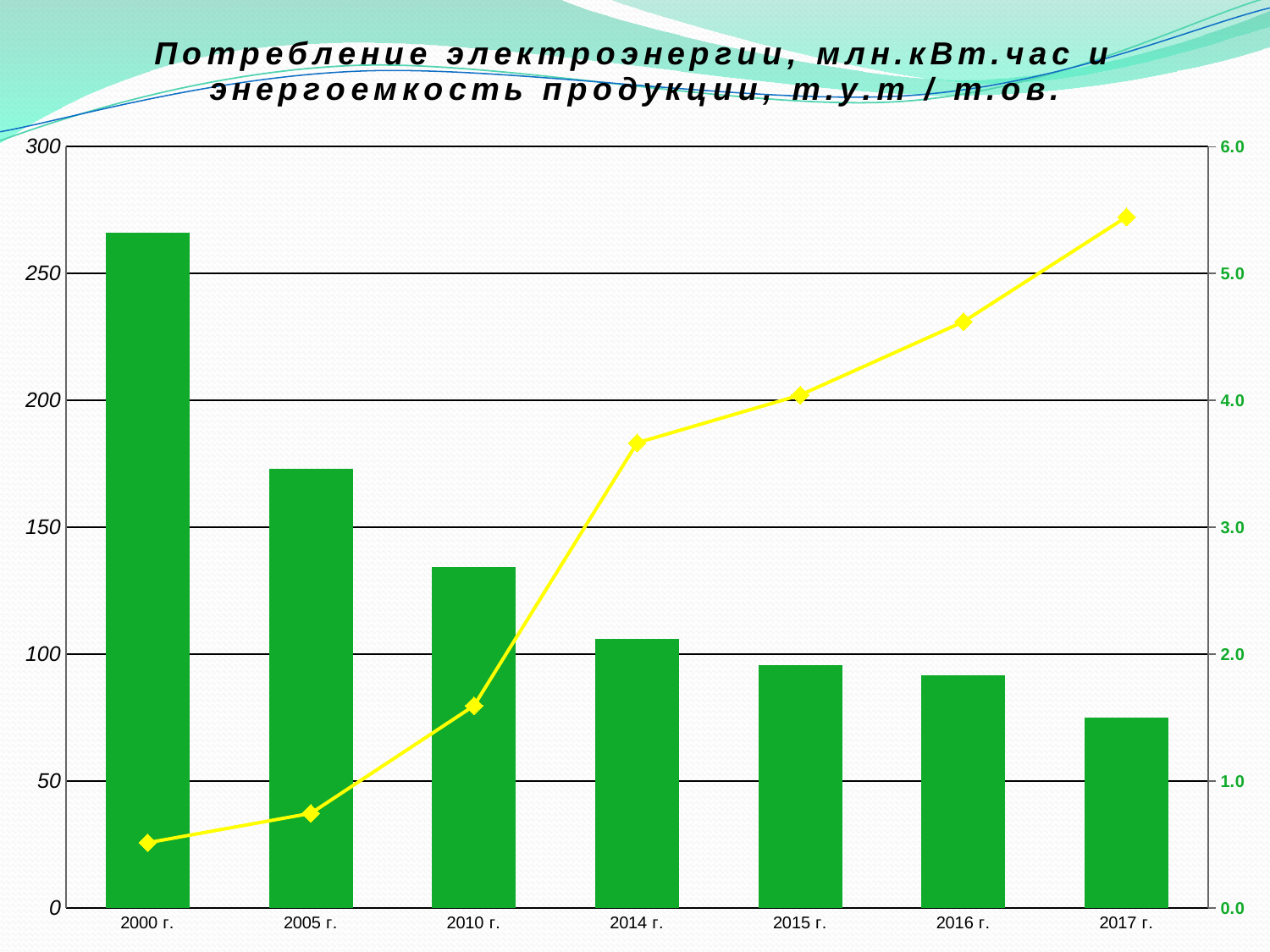
Do the green bars rise or fall from 2000 to 2017? Fall Is the green bar for 2010 г. greater or less than 150? less What kind of chart is shown on the slide? A combined bar and line chart Which green bar is taller, 2005 г. or 2010 г.? 2005 г. Which year has the shortest green bar? 2017 г. What is the highest value shown on the right-hand axis? 6.0 Is the green bar for 2000 г. greater or less than 250? greater How many years are shown on the x axis of the chart? 7 Is the green bar for 2017 г. greater or less than 100? less Which year has the tallest green bar? 2000 г. Does the yellow line rise or fall from 2000 to 2017? Rise